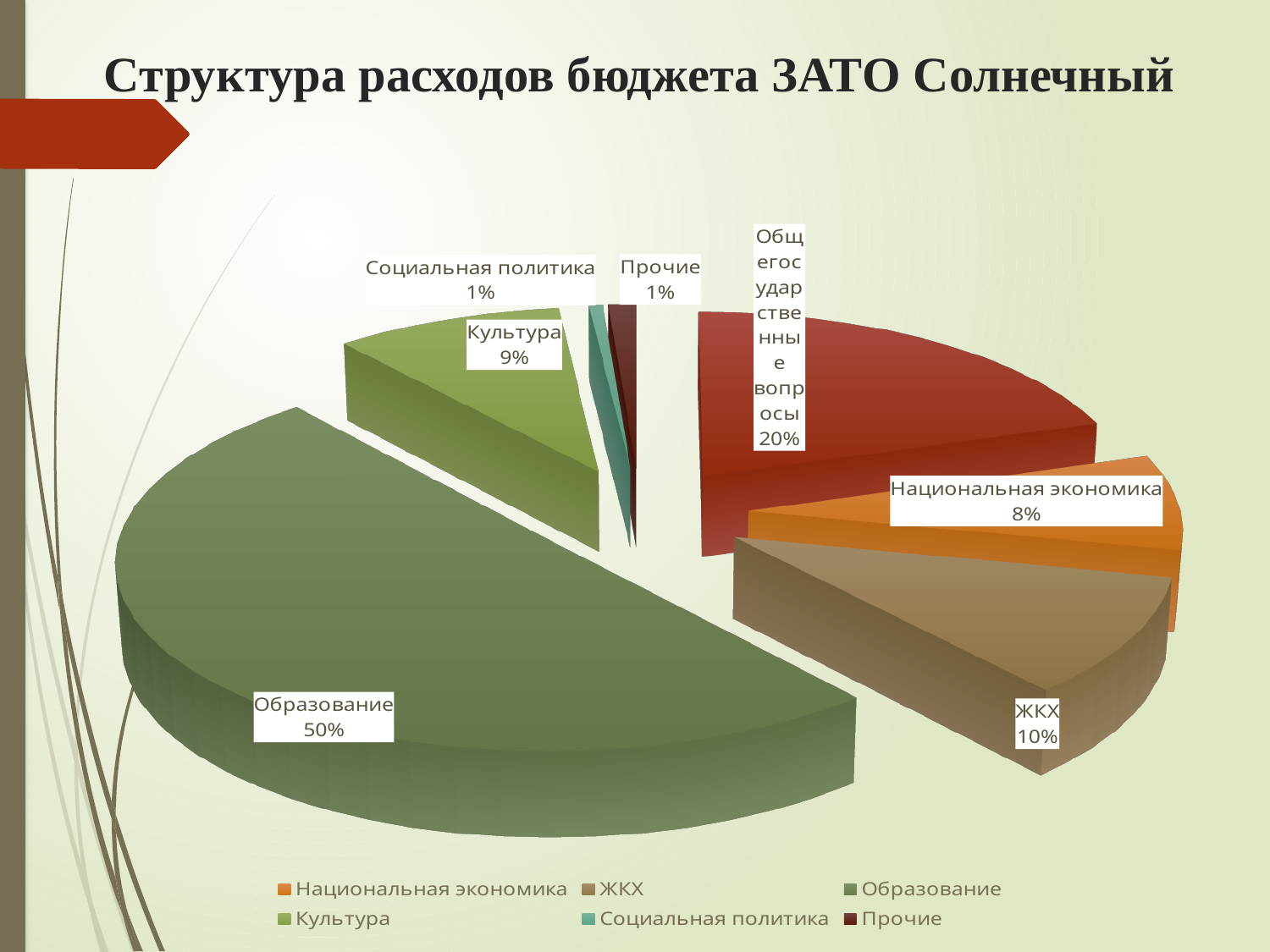
What is the value for Национальная экономика? 8% What percentage is shown for Культура? 9% How many slices does the pie chart have? 7 Which is larger, the share for ЖКХ or the share for Национальная экономика? ЖКХ How many entries does the legend list? 6 What kind of chart is shown on the slide? pie chart What is the title of the slide? Структура расходов бюджета ЗАТО Солнечный What share of the budget expenditure goes to Образование? 50% Which category has the largest share of the pie? Образование What is the value shown for Общегосударственные вопросы? 20% What is the difference between the shares of Образование and Общегосударственные вопросы? 30% What percentage is shown for ЖКХ? 10%